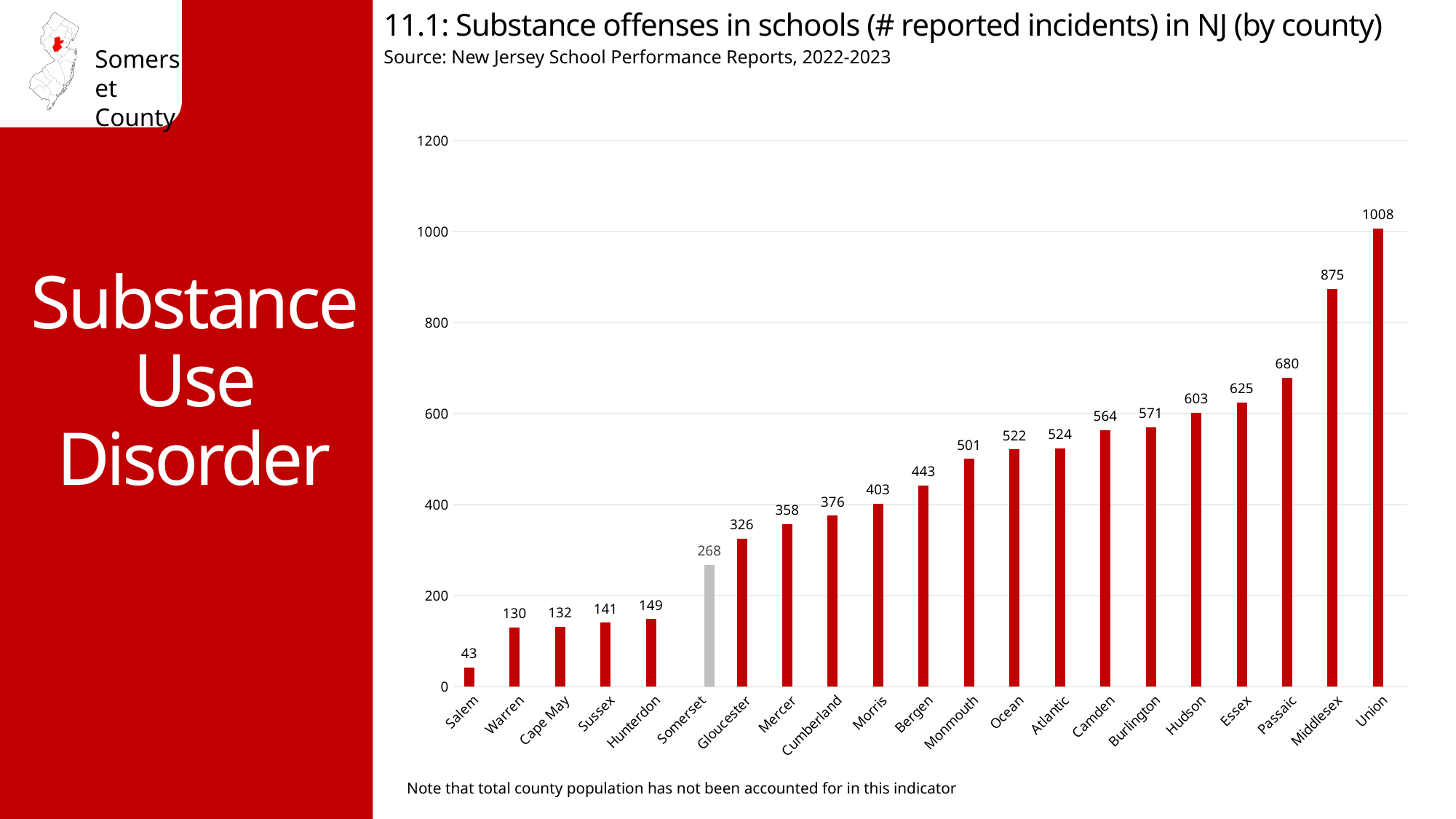
What kind of chart is shown on the slide? Bar chart How many counties are shown on the chart? 21 How many reported incidents are shown for Bergen County? 443 Which has a higher value, Essex or Hudson? Essex Is the value for Passaic greater or less than 600? greater What is the difference between the values for Hunterdon and Salem? 106 Which county has the lowest number of reported incidents? Salem Which county's bar is shown in grey rather than red? Somerset What is the difference between the values for Middlesex and Somerset? 607 What is the number of reported substance offense incidents for Somerset County? 268 Which county has the highest number of reported incidents? Union What is the value shown for Union County? 1008